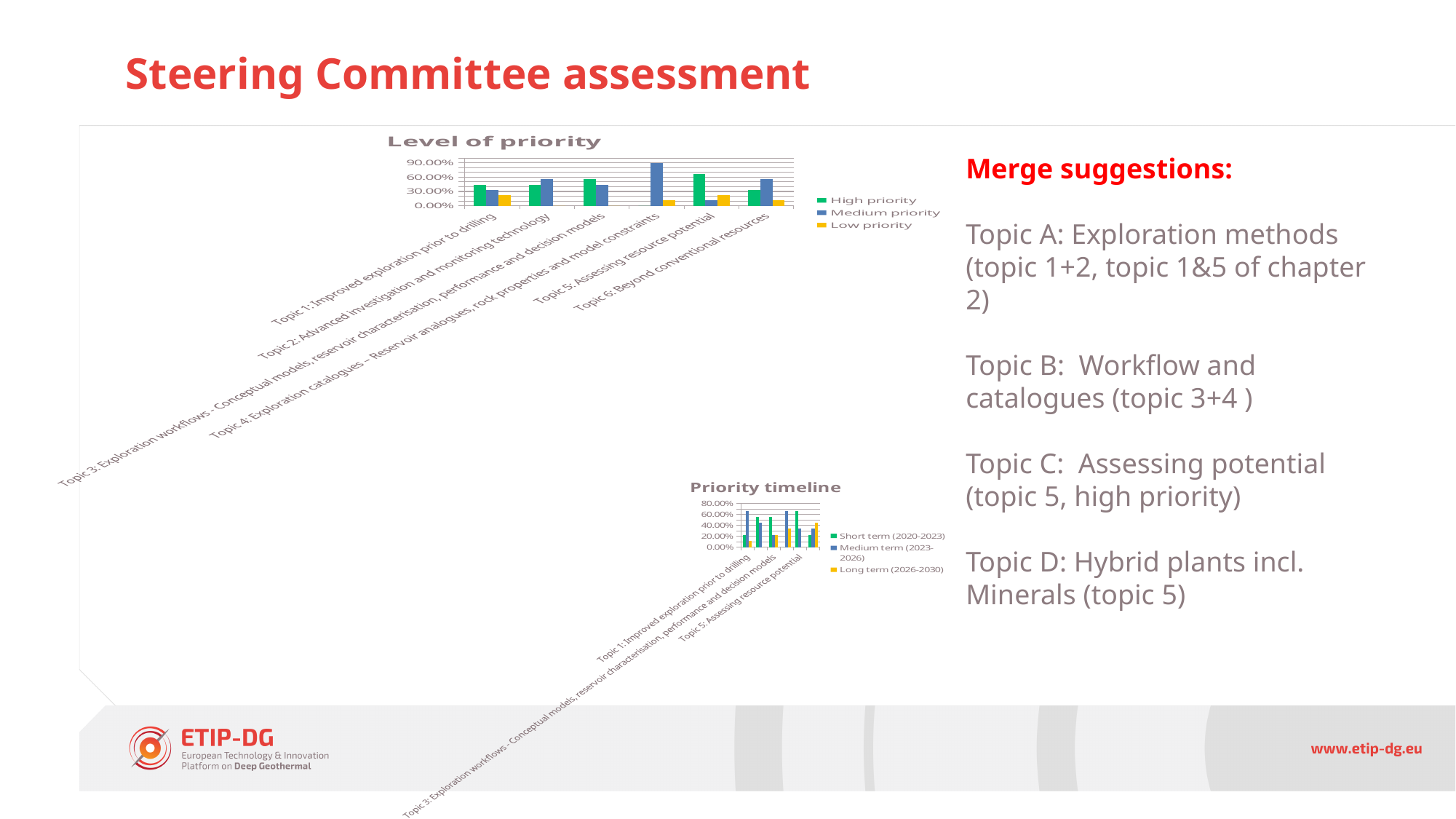
In the "Level of priority" chart, which is larger for Topic 2: the High priority bar or the Medium priority bar? Medium priority In the "Level of priority" chart, which topic has the highest Medium priority bar? Topic 4: Exploration catalogues – Reservoir analogues, rock properties and model constraints What kind of chart is the "Level of priority" chart? bar chart How many topics are shown on the x axis of the "Priority timeline" chart? 6 How many series does the legend of the "Level of priority" chart list? 3 What colour represents Low priority in the "Level of priority" chart? yellow How many topics are shown on the x axis of the "Level of priority" chart? 6 In the "Level of priority" chart, is the High priority value for Topic 5 greater or less than 30.00%? greater How many series does the legend of the "Priority timeline" chart list? 3 In the "Level of priority" chart, is the Medium priority value for Topic 4 greater or less than 60.00%? greater In the "Level of priority" chart, which topic has the highest High priority bar? Topic 5: Assessing resource potential In the "Priority timeline" chart, which is larger for Topic 5: the Short term (2020-2023) bar or the Medium term (2023-2026) bar? Short term (2020-2023)